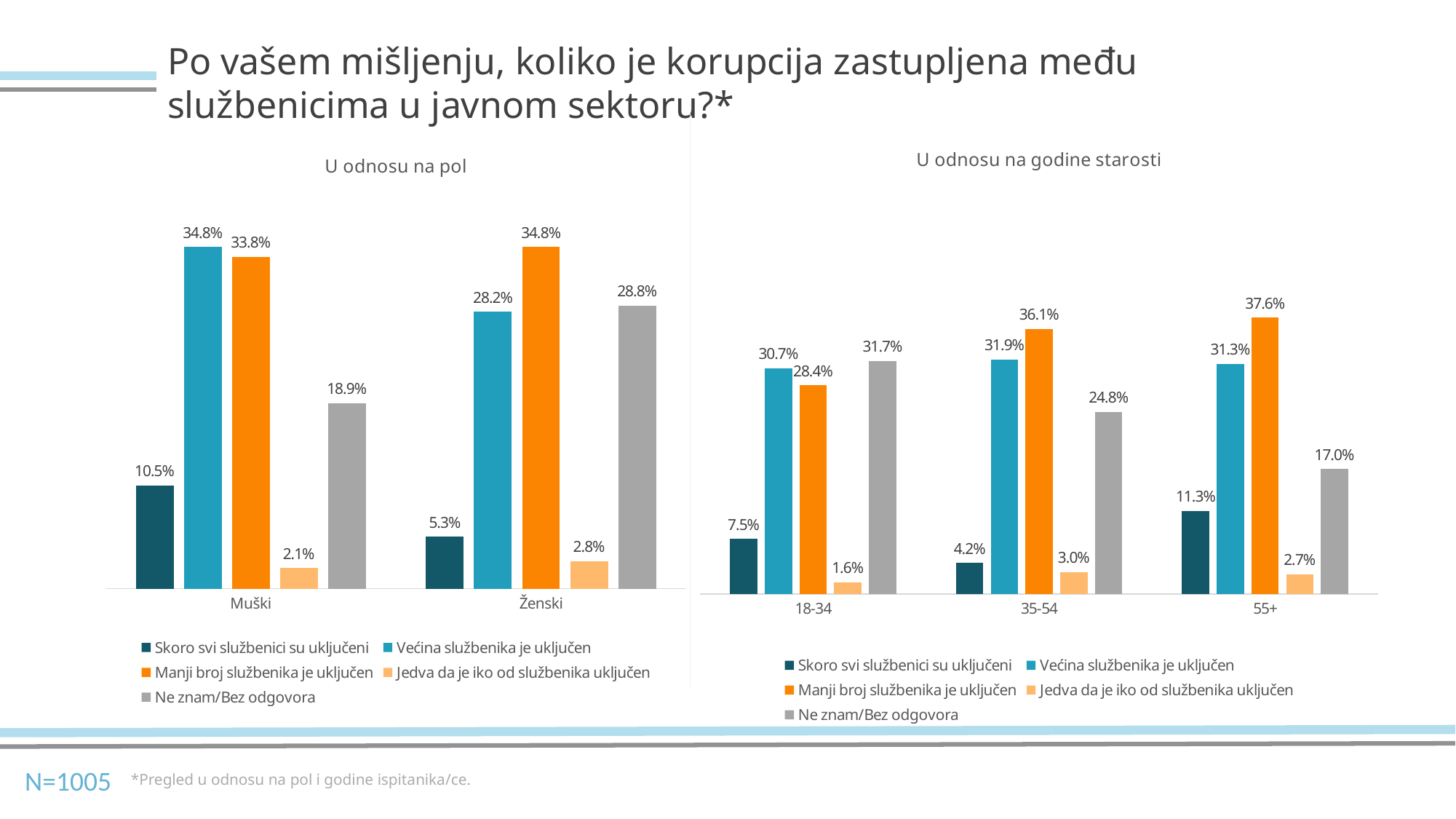
In the chart 'U odnosu na pol', how many series does the legend list? 5 In the chart 'U odnosu na godine starosti', how many age groups are shown on the x axis? 3 In the chart 'U odnosu na godine starosti', what is the value for 'Manji broj službenika je uključen' for 55+? 37.6% In the chart 'U odnosu na pol', which series has the lowest value for Muški? Jedva da je iko od službenika uključen In the chart 'U odnosu na pol', what is the value for 'Skoro svi službenici su uključeni' for Muški? 10.5% What type of chart is 'U odnosu na pol'? Bar chart In the chart 'U odnosu na godine starosti', what is the difference between 'Skoro svi službenici su uključeni' for 55+ and for 35-54? 7.1% In the chart 'U odnosu na godine starosti', which is larger for 35-54: 'Većina službenika je uključen' or 'Manji broj službenika je uključen'? Manji broj službenika je uključen In the chart 'U odnosu na pol', what is the value for 'Ne znam/Bez odgovora' for Ženski? 28.8% In the chart 'U odnosu na godine starosti', which age group has the highest value for 'Ne znam/Bez odgovora'? 18-34 In the chart 'U odnosu na pol', what is the difference between 'Većina službenika je uključen' for Muški and for Ženski? 6.6% In the chart 'U odnosu na godine starosti', what is the value for 'Jedva da je iko od službenika uključen' for 18-34? 1.6%